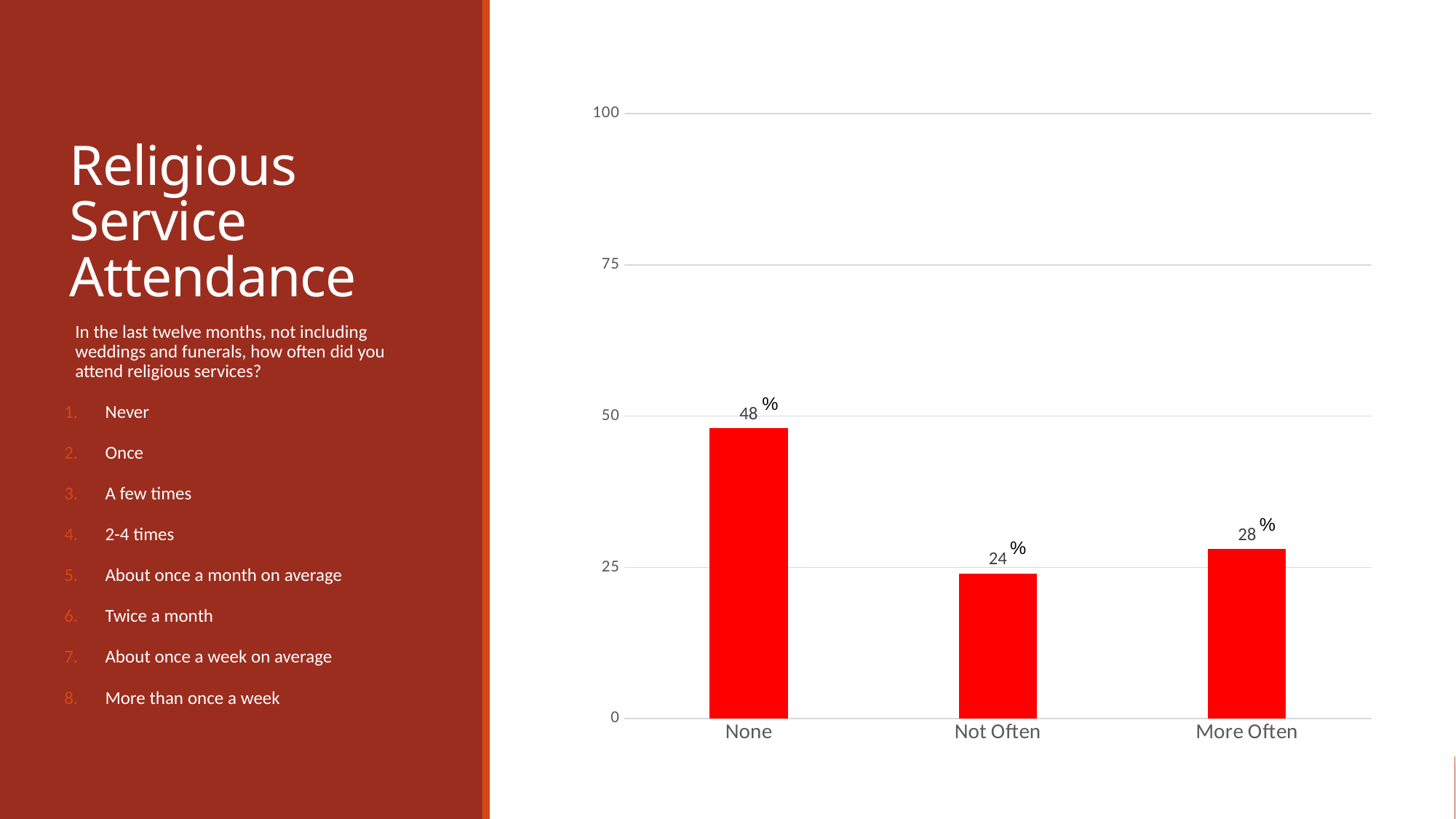
How many categories are shown on the x axis? 3 Is the value for None greater or less than 25? greater Which category has the highest value? None What is the value for None? 48% Which is larger, the value for None or the value for More Often? None What colour are the bars in the chart? Red What is the difference between the values for More Often and Not Often? 4% What is the difference between the values for None and Not Often? 24% Which category has the lowest value? Not Often What is the value for Not Often? 24% What kind of chart is shown on the slide? Bar chart What is the value for More Often? 28%